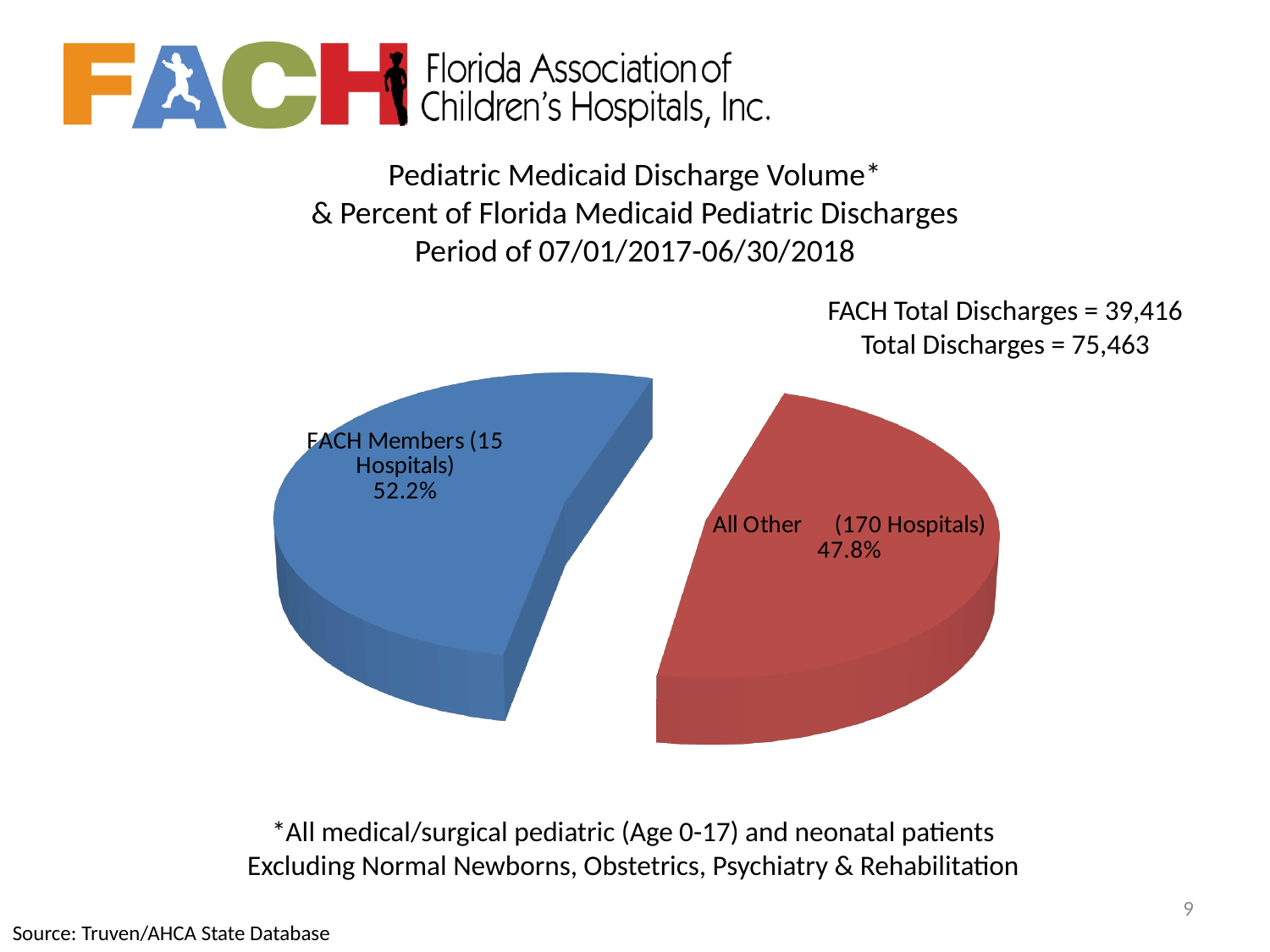
What percentage of Florida Medicaid pediatric discharges is attributed to FACH Members (15 Hospitals)? 52.2% What is the Total Discharges figure stated on the slide? 75,463 What is the FACH Total Discharges figure stated on the slide? 39,416 What kind of chart is shown on the slide? Pie chart Which is larger, the share for FACH Members (15 Hospitals) or the share for All Other (170 Hospitals)? FACH Members (15 Hospitals) What colour is the slice representing FACH Members (15 Hospitals)? Blue Which slice of the pie chart is the smallest? All Other (170 Hospitals) Is the share for All Other (170 Hospitals) greater or less than 50%? less What percentage of Florida Medicaid pediatric discharges is attributed to All Other (170 Hospitals)? 47.8% What is the difference in percentage points between the FACH Members slice and the All Other slice? 4.4 percentage points Which slice of the pie chart is the largest? FACH Members (15 Hospitals) How many slices does the pie chart have? 2